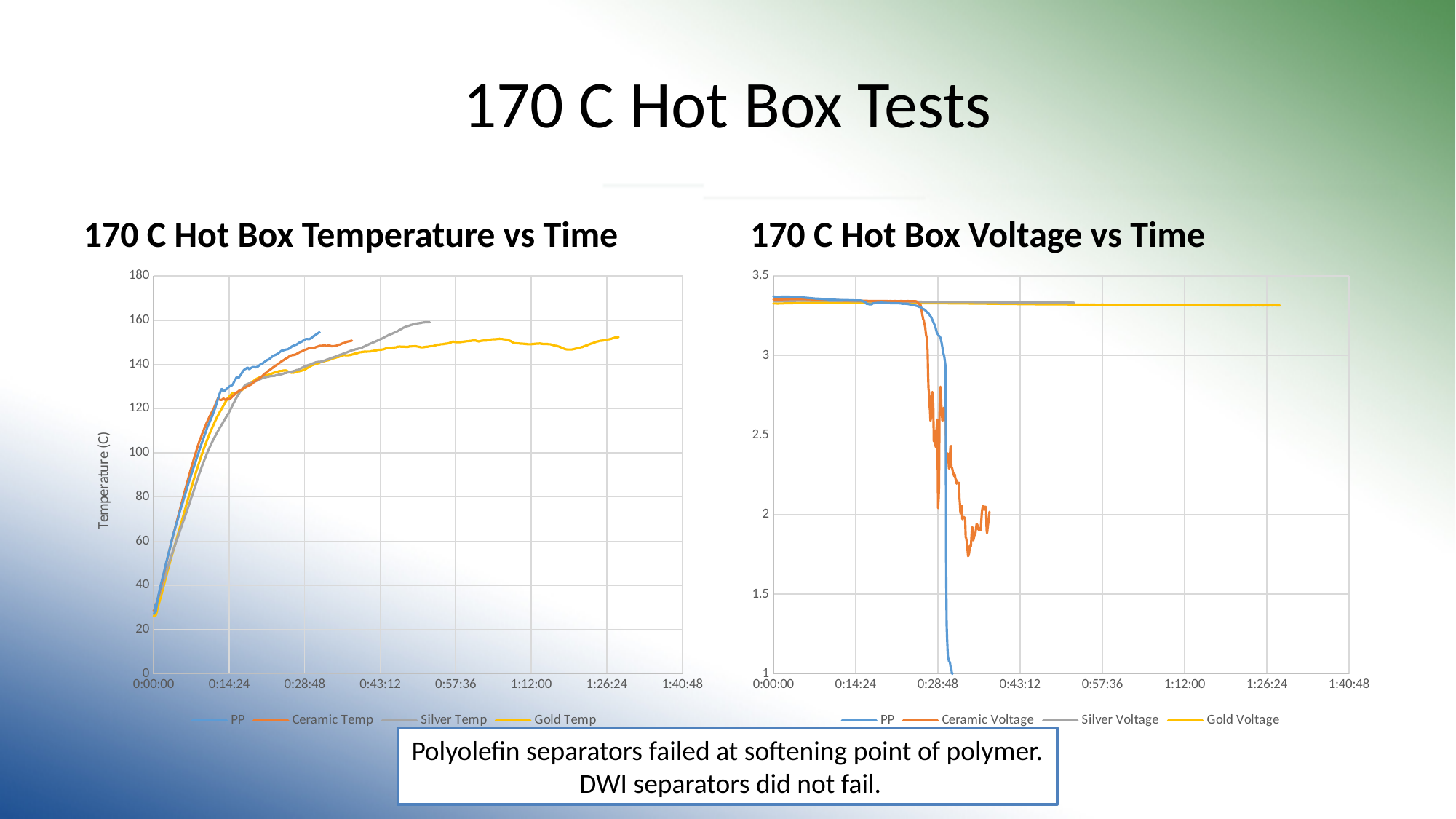
What is the y-axis label of the '170 C Hot Box Temperature vs Time' chart? Temperature (C) In the '170 C Hot Box Voltage vs Time' chart, is the Gold Voltage value at 1:26:24 greater or less than 3? greater In the '170 C Hot Box Voltage vs Time' chart, is the Ceramic Voltage value at about 0:36:00 greater or less than 2.5? less How many series does the legend of the '170 C Hot Box Voltage vs Time' chart list? 4 In the '170 C Hot Box Temperature vs Time' chart, is the Gold Temp value at 1:26:24 greater or less than 140? greater How many series does the legend of the '170 C Hot Box Temperature vs Time' chart list? 4 What kind of chart is the '170 C Hot Box Temperature vs Time' chart? line chart What kind of chart is the '170 C Hot Box Voltage vs Time' chart? line chart In the '170 C Hot Box Temperature vs Time' chart, which series extends furthest along the time axis? Gold Temp In the '170 C Hot Box Temperature vs Time' chart, do the temperature lines rise or fall over time? rise In the '170 C Hot Box Voltage vs Time' chart, does the PP line rise or fall after about 0:28:48? fall In the '170 C Hot Box Voltage vs Time' chart, which series drops to the lowest voltage? PP